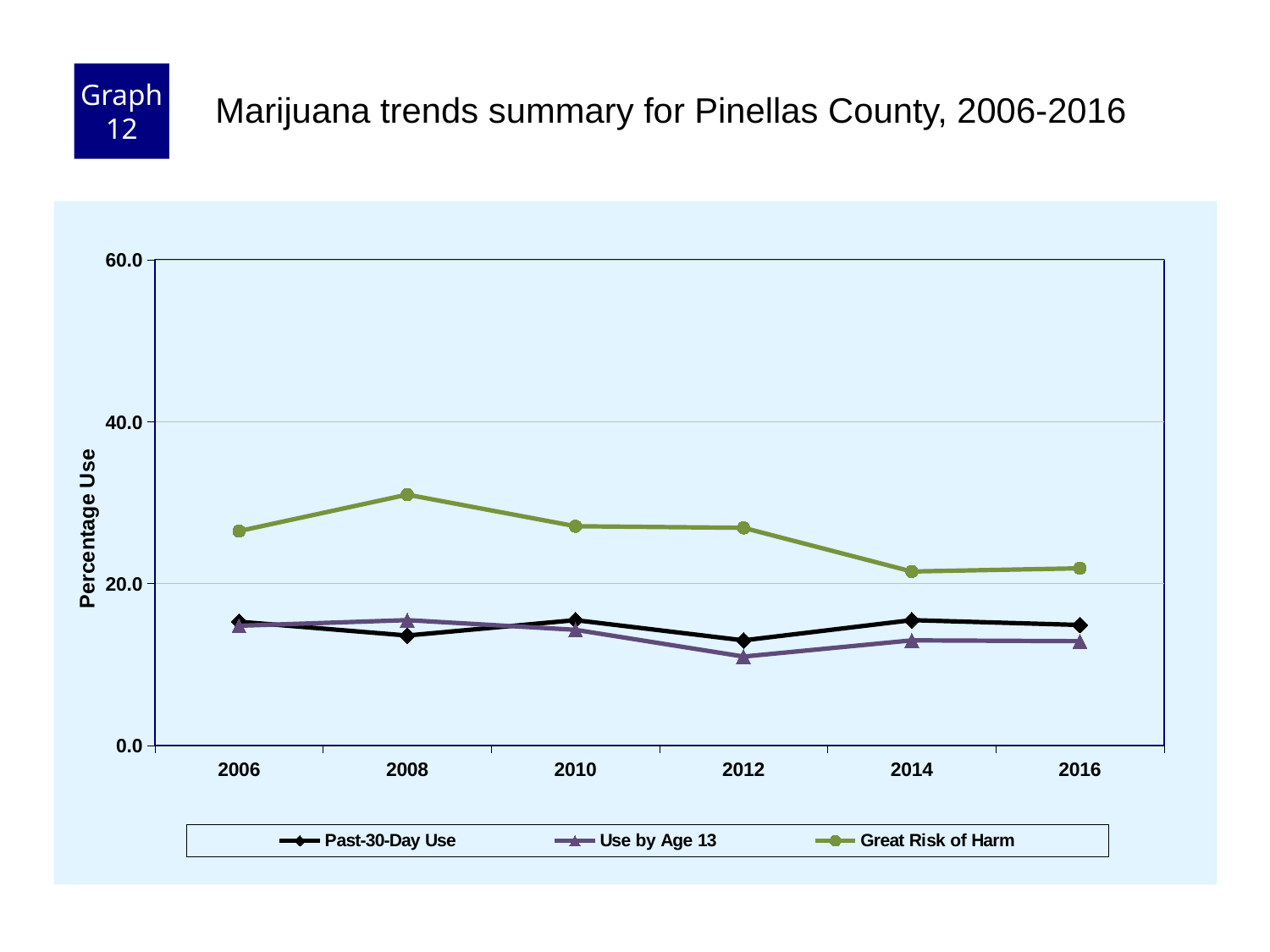
In which year is the Use by Age 13 series at its lowest? 2012 What type of chart is shown on the slide? Line chart How many series does the legend list? 3 In which year does the Great Risk of Harm series reach its highest value? 2008 In which year is the Past-30-Day Use series at its lowest? 2012 How many years are plotted along the x axis? 6 Is the value for Great Risk of Harm in 2008 greater or less than 20.0? greater In 2014, which series has the higher value: Great Risk of Harm or Past-30-Day Use? Great Risk of Harm What is the label on the y axis? Percentage Use Does the Great Risk of Harm series rise or fall between 2012 and 2014? Fall Is the value for Great Risk of Harm in 2008 greater or less than 40.0? less Is the value for Past-30-Day Use in 2012 greater or less than 20.0? less